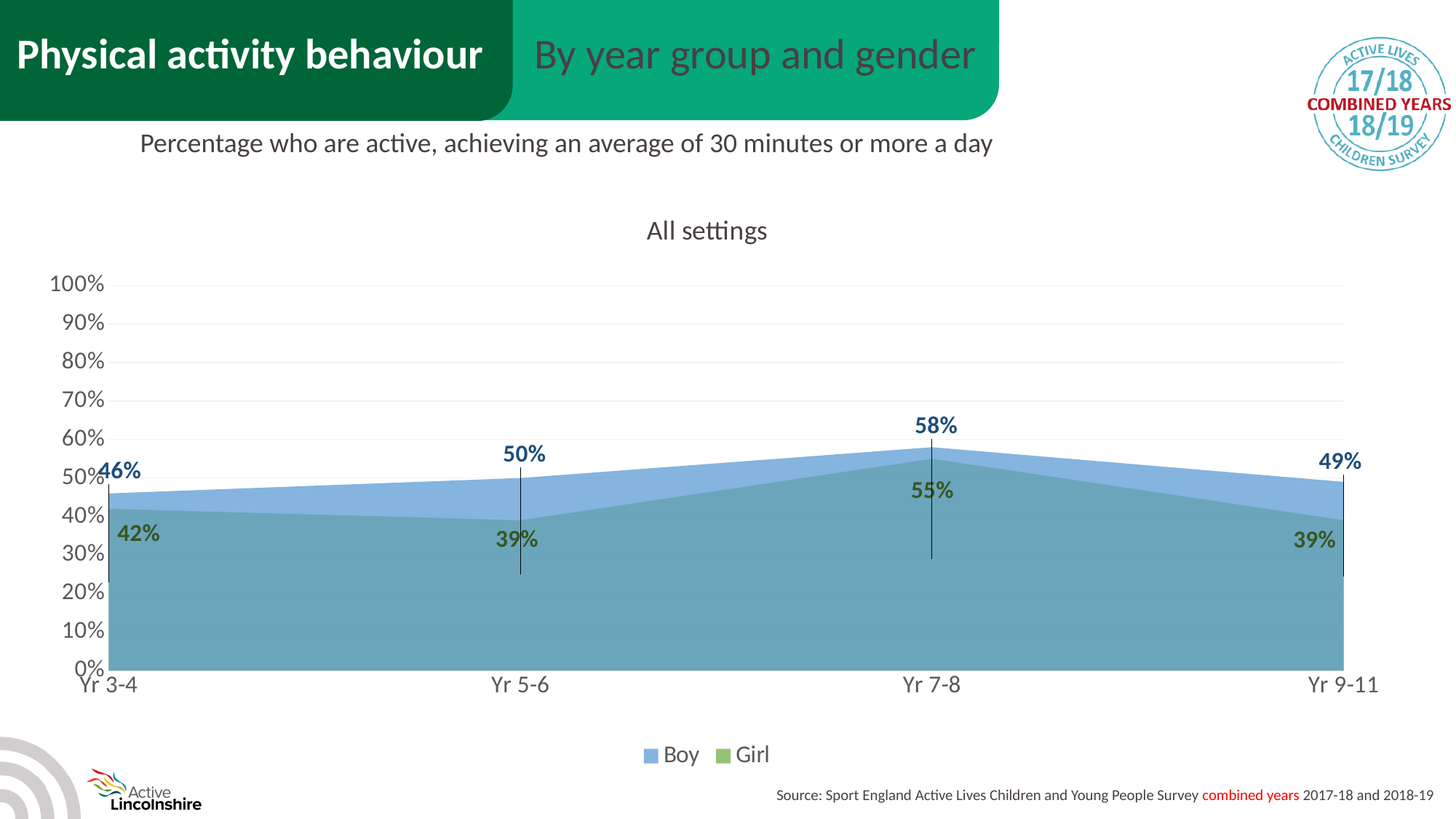
What is the difference between the Boy value in Yr 7-8 and the Boy value in Yr 9-11? 9% How many series does the legend list? 2 What is the value for Girl in Yr 9-11? 39% Which year group has the highest value for Boy? Yr 7-8 What is the difference between the Boy and Girl values in Yr 5-6? 11% What is the value for Girl in Yr 5-6? 39% What is the value for Boy in Yr 7-8? 58% What is the value for Boy in Yr 3-4? 46% Which is larger, the Girl value in Yr 3-4 or the Girl value in Yr 5-6? Yr 3-4 How many year groups are shown on the x axis? 4 What kind of chart is shown on the slide? Area chart Which year group has the lowest value for Boy? Yr 3-4